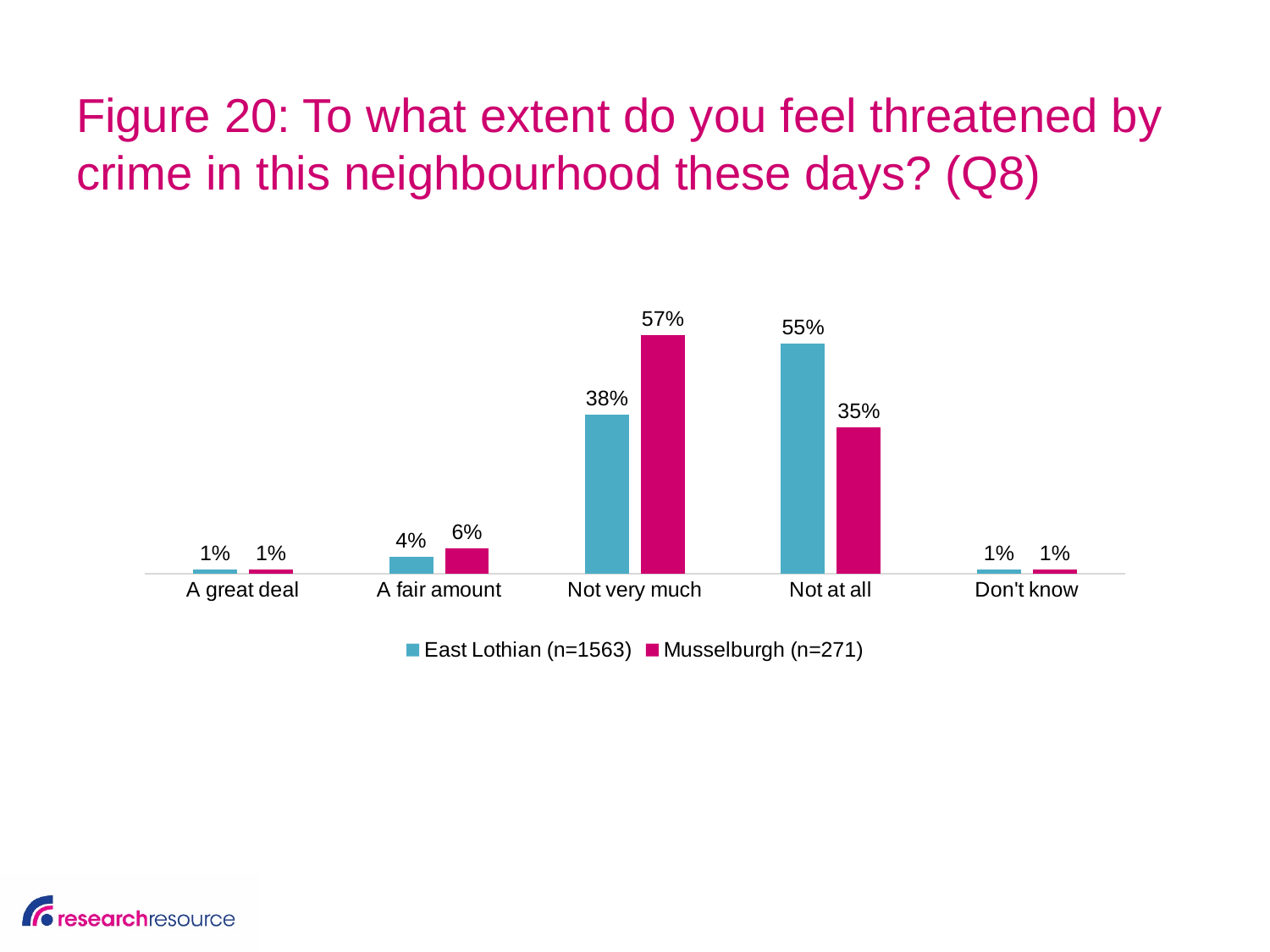
What is the difference between the East Lothian and Musselburgh values for 'Not at all'? 20 percentage points Which category has the highest value for Musselburgh? Not very much What kind of chart is shown on the slide? Bar chart How many series does the legend list? 2 What percentage of East Lothian respondents said 'Not very much'? 38% Which category has the highest value for East Lothian? Not at all What percentage of Musselburgh respondents said 'A fair amount'? 6% What percentage of Musselburgh respondents said 'Not at all'? 35% How many response categories are shown on the x axis? 5 What is the difference between the Musselburgh and East Lothian values for 'Not very much'? 19 percentage points For 'A fair amount', which series has the larger value, East Lothian or Musselburgh? Musselburgh What is the sample size for Musselburgh shown in the legend? n=271